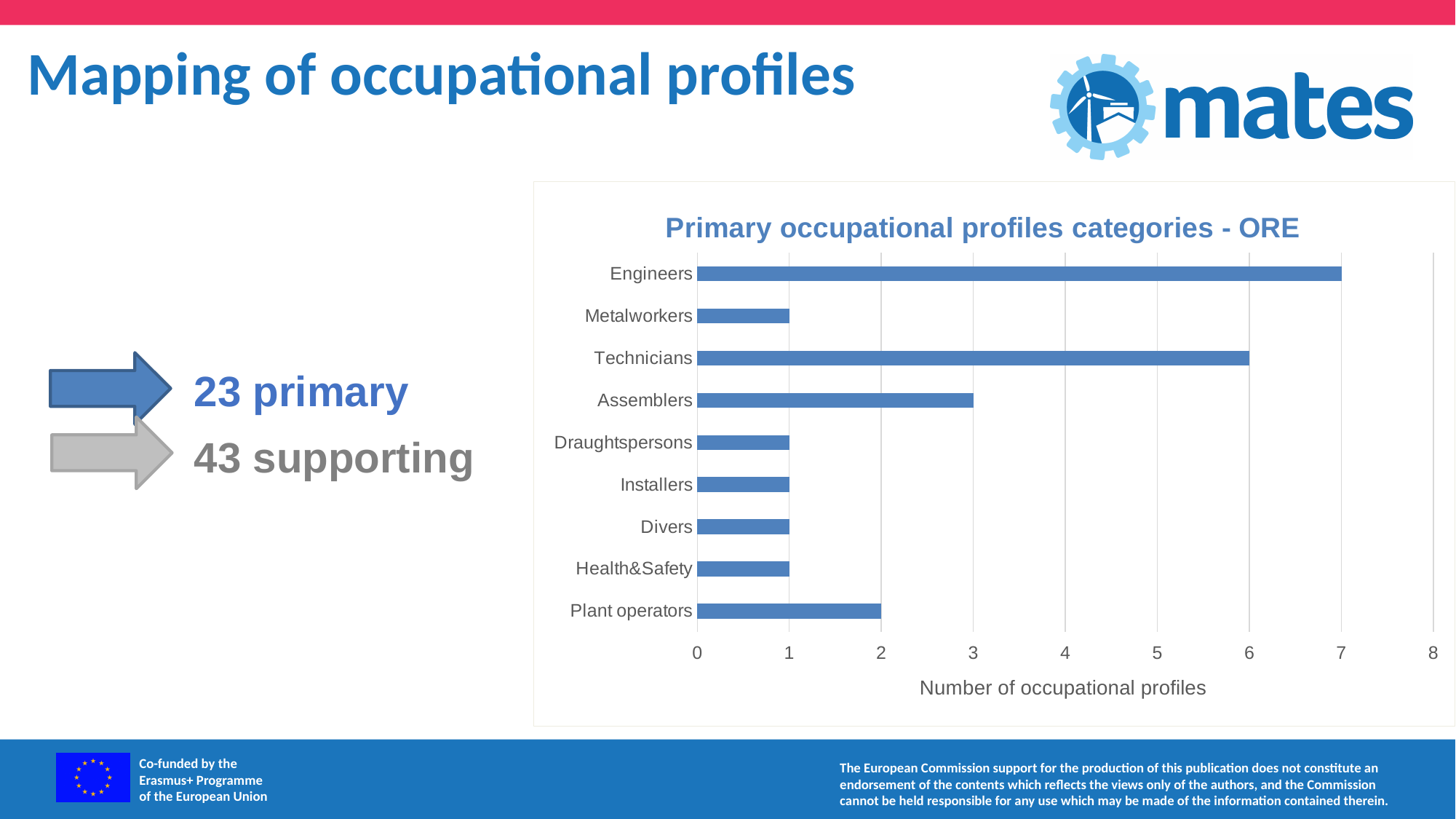
What kind of chart is shown on the slide? Bar chart What is the difference between the number of occupational profiles for Engineers and Technicians? 1 Which has more occupational profiles, Assemblers or Plant operators? Assemblers What is the number of occupational profiles for Technicians? 6 Is the value for Technicians greater or less than 5? greater What is the number of occupational profiles for Engineers? 7 What is the label of the horizontal axis? Number of occupational profiles What is the number of occupational profiles for Assemblers? 3 Which category has the highest number of occupational profiles? Engineers How many categories are plotted in the chart? 9 What is the number of occupational profiles for Plant operators? 2 What is the title of the chart? Primary occupational profiles categories - ORE